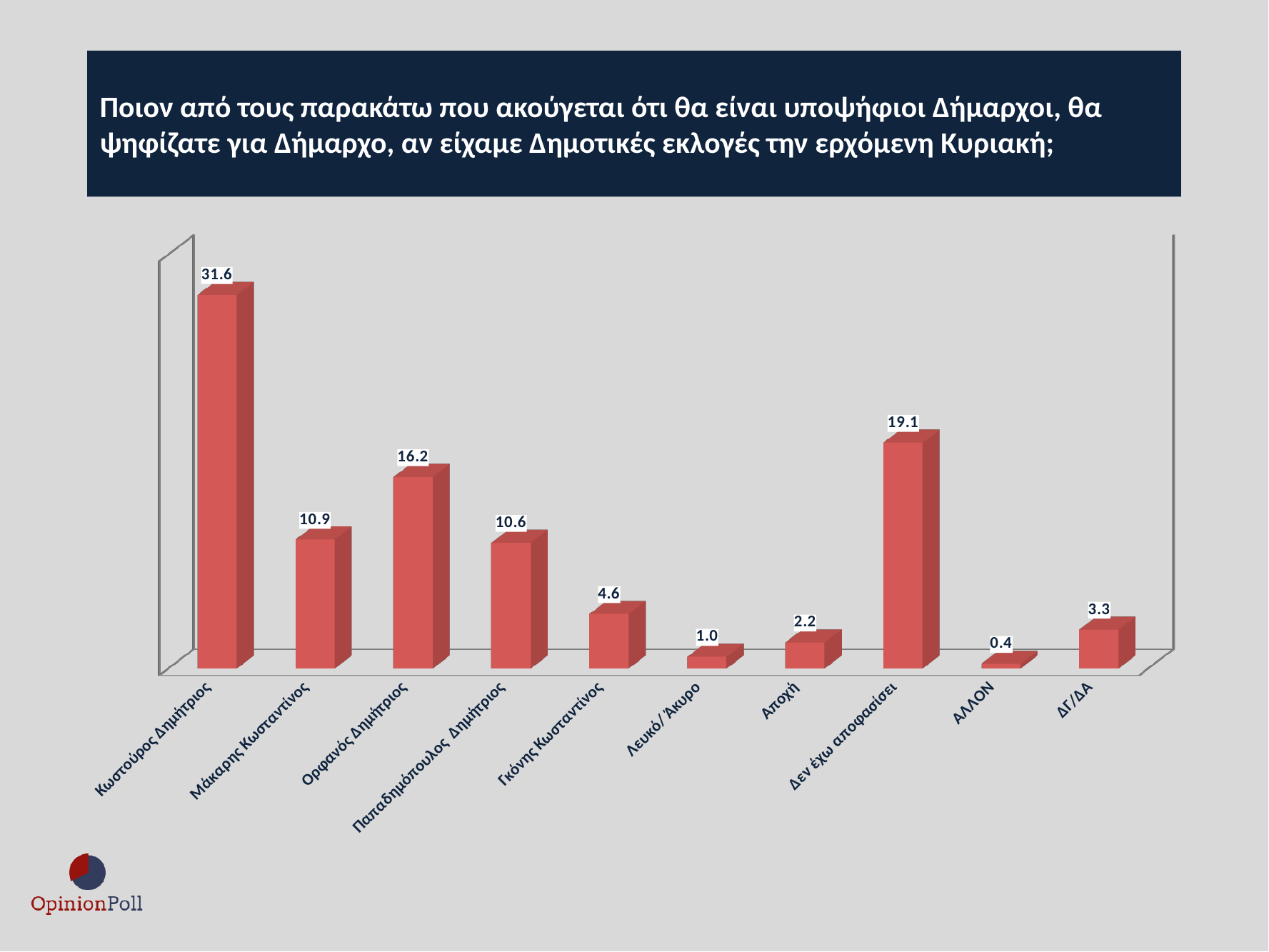
What is the value for Αποχή? 2.2 What is the value for ΑΛΛΟΝ? 0.4 Which category has the lowest value? ΑΛΛΟΝ What is the difference between the values for Κωστούρος Δημήτριος and Ορφανός Δημήτριος? 15.4 What is the value for Ορφανός Δημήτριος? 16.2 How many categories are shown on the chart? 10 Which is larger, the value for Γκόνης Κωσταντίνος or the value for ΔΓ/ΔΑ? Γκόνης Κωσταντίνος What is the difference between the values for Μάκαρης Κωσταντίνος and Παπαδημόπουλος Δημήτριος? 0.3 What is the value for Δεν έχω αποφασίσει? 19.1 What kind of chart is shown on the slide? bar chart What is the value for Κωστούρος Δημήτριος? 31.6 Which category has the highest value? Κωστούρος Δημήτριος